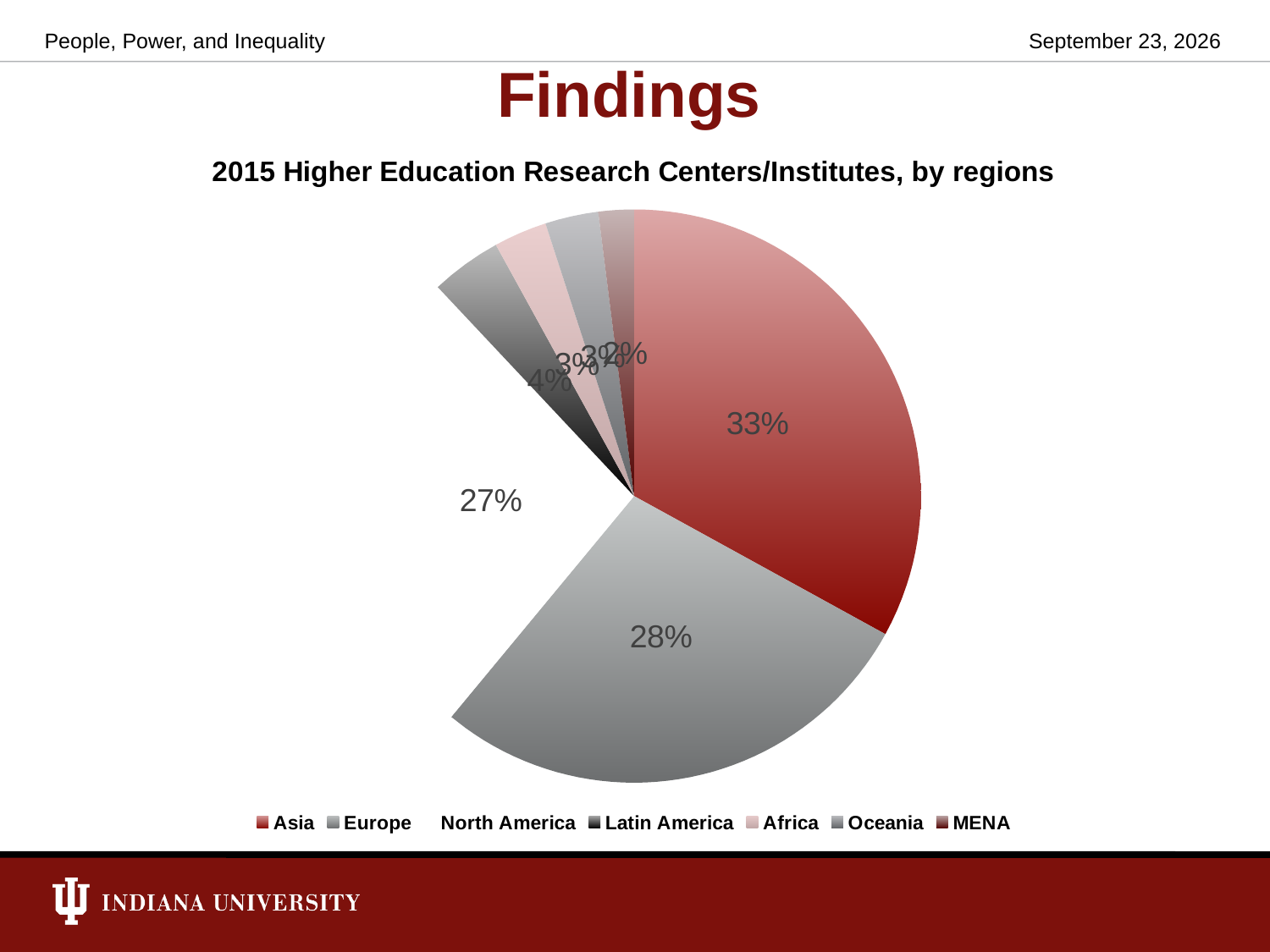
Which region has the largest share of the pie? Asia Which has a larger share, Europe or North America? Europe Which has a larger share, Asia or North America? Asia What share of the pie does Asia hold? 33% What colour is the Asia slice? red What is the title of the chart? 2015 Higher Education Research Centers/Institutes, by regions What kind of chart is shown on the slide? pie chart How many regions does the legend list? 7 What share of the pie does North America hold? 27% What is the difference in percentage points between Asia's share and Europe's share? 5 percentage points What is the combined share of Asia and Europe? 61% What share of the pie does Europe hold? 28%